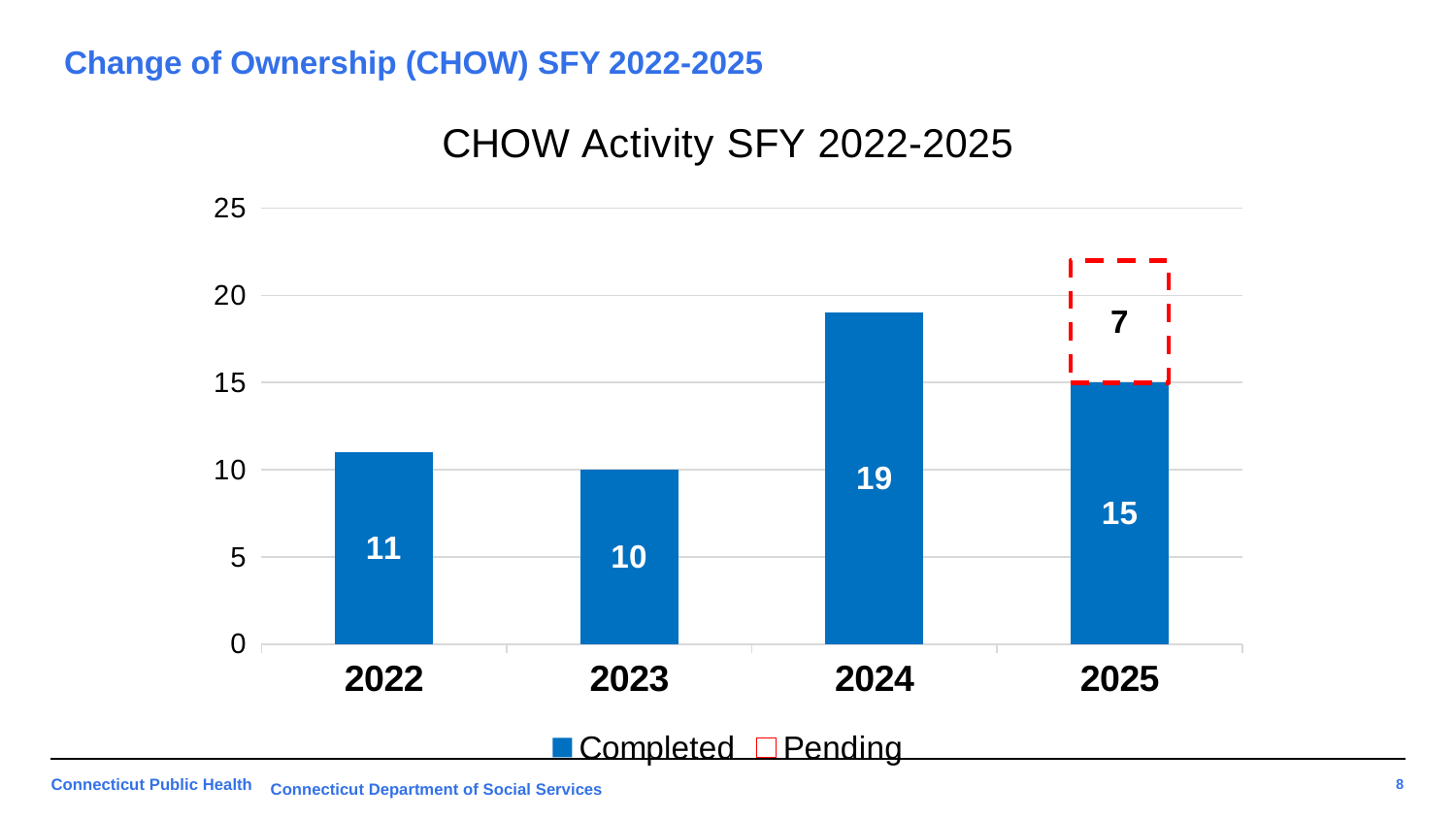
What kind of chart is shown? Bar chart What is the Completed value for 2022? 11 Which is larger, the Completed value for 2022 or for 2025? 2025 What is the title of the chart? CHOW Activity SFY 2022-2025 How many series does the legend list? 2 What is the Completed value for 2024? 19 How many years are shown on the x axis? 4 Which year has the lowest Completed value? 2023 What is the difference between the Completed values for 2024 and 2023? 9 Which year has the highest Completed value? 2024 What is the Pending value for 2025? 7 What is the total of the stacked bar for 2025 (Completed plus Pending)? 22